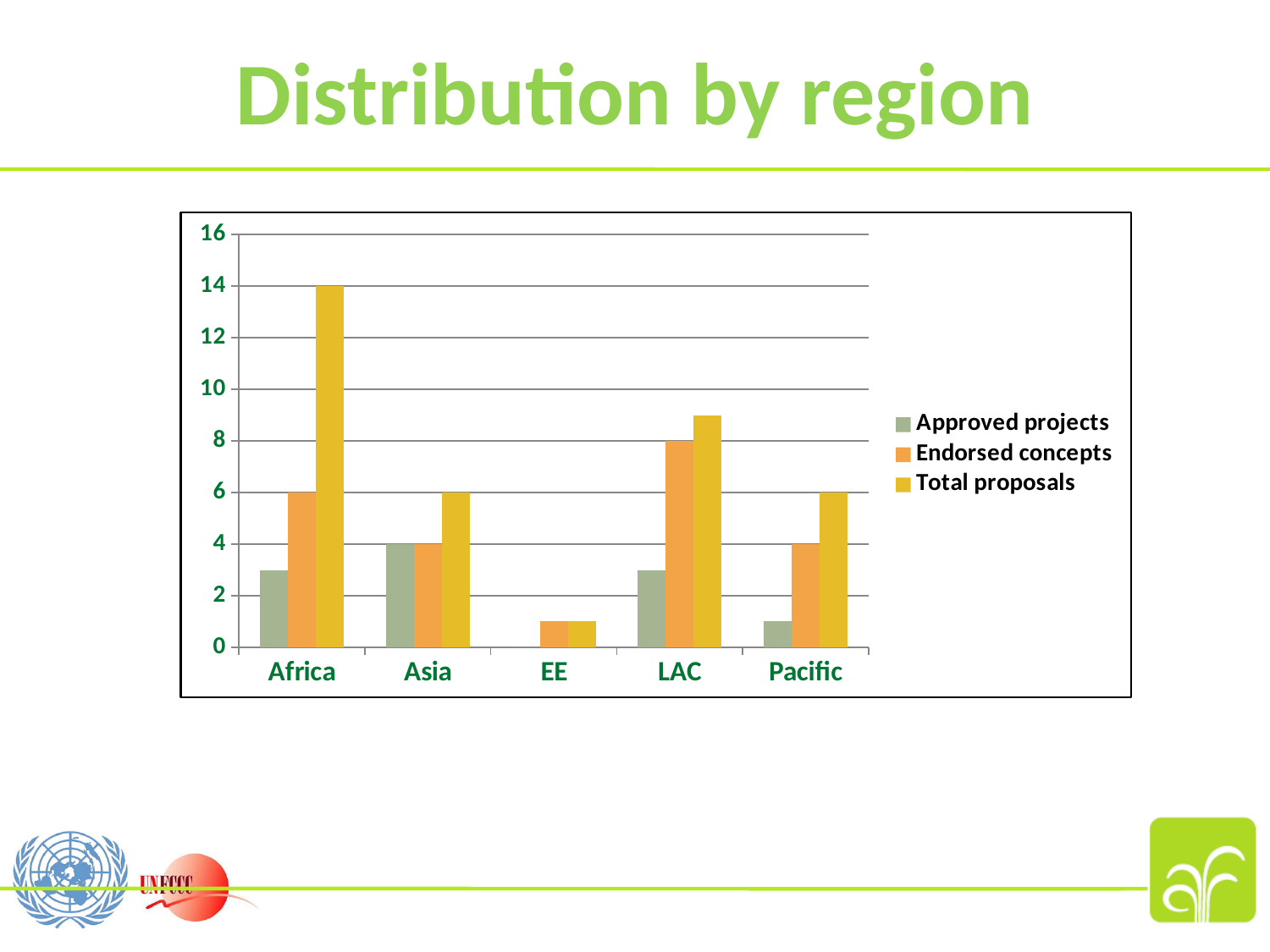
What is the difference between Total proposals and Endorsed concepts for Africa? 8 Which is larger: Endorsed concepts for LAC or Endorsed concepts for Pacific? Endorsed concepts for LAC What is the value of Approved projects for Asia? 4 Which region has the lowest value for Total proposals? EE What is the value of Total proposals for Africa? 14 What kind of chart is shown on the slide? bar chart What is the value of Endorsed concepts for LAC? 8 Is the value of Total proposals for LAC greater or less than 10? less How many series does the legend list? 3 How many regions are shown on the x axis? 5 Which region has the highest value for Total proposals? Africa What is the value of Total proposals for Pacific? 6